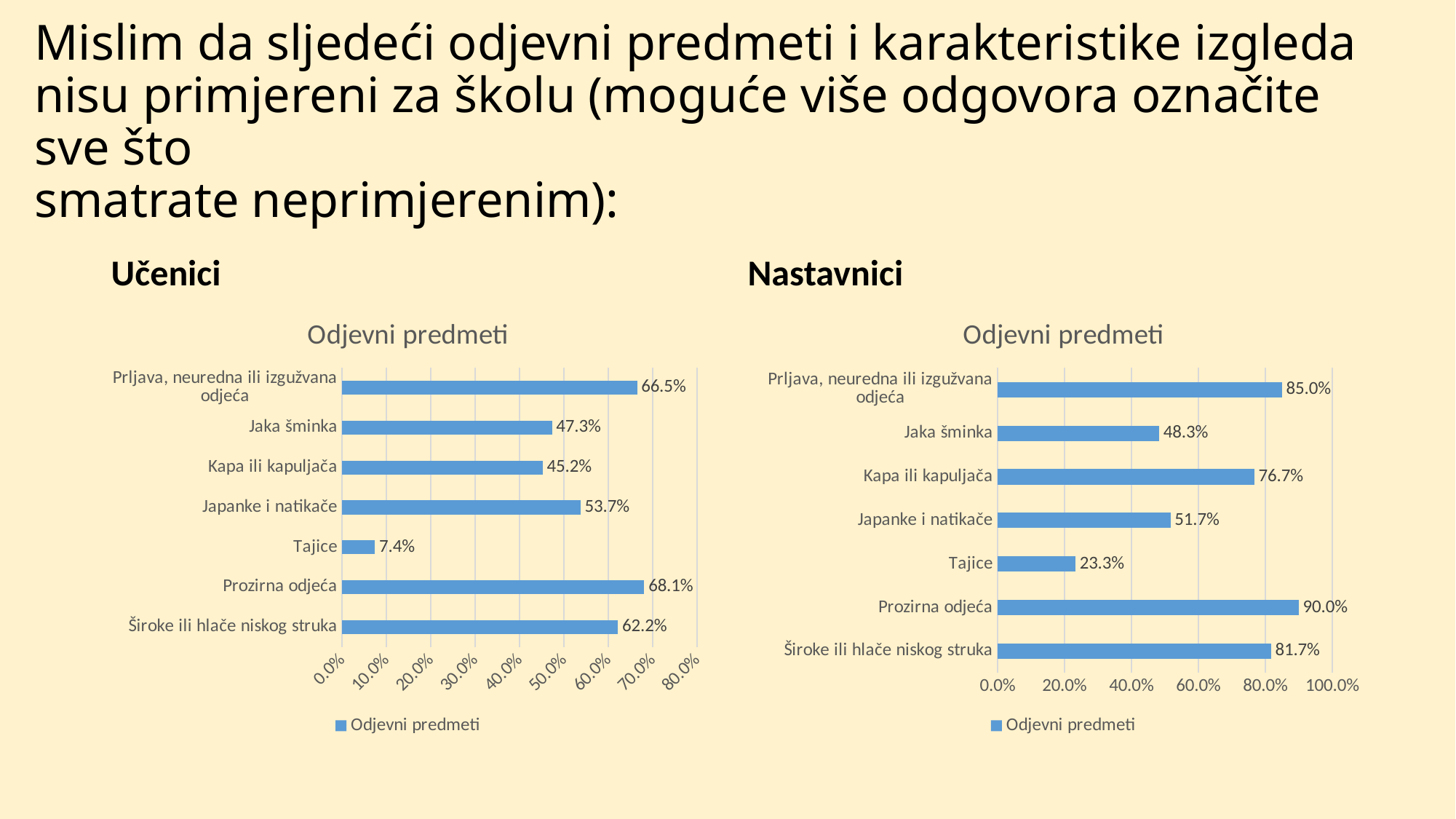
In the Nastavnici chart (right), what is the difference between Prozirna odjeća and Tajice? 66.7% In the Učenici chart (left), how many categories are shown? 7 What is the title of the Nastavnici chart (right)? Odjevni predmeti In the Nastavnici chart (right), is the value for Široke ili hlače niskog struka greater or less than 80.0%? greater In the Učenici chart (left), what is the value for Tajice? 7.4% In the Nastavnici chart (right), what is the value for Kapa ili kapuljača? 76.7% What type of chart is the Učenici chart (left)? Bar chart In the Nastavnici chart (right), which category has the lowest value? Tajice In the Učenici chart (left), which is larger: Jaka šminka or Japanke i natikače? Japanke i natikače In the Učenici chart (left), what is the difference between Prljava, neuredna ili izgužvana odjeća and Kapa ili kapuljača? 21.3% How many series does the legend of the Nastavnici chart (right) list? 1 In the Učenici chart (left), which category has the highest value? Prozirna odjeća